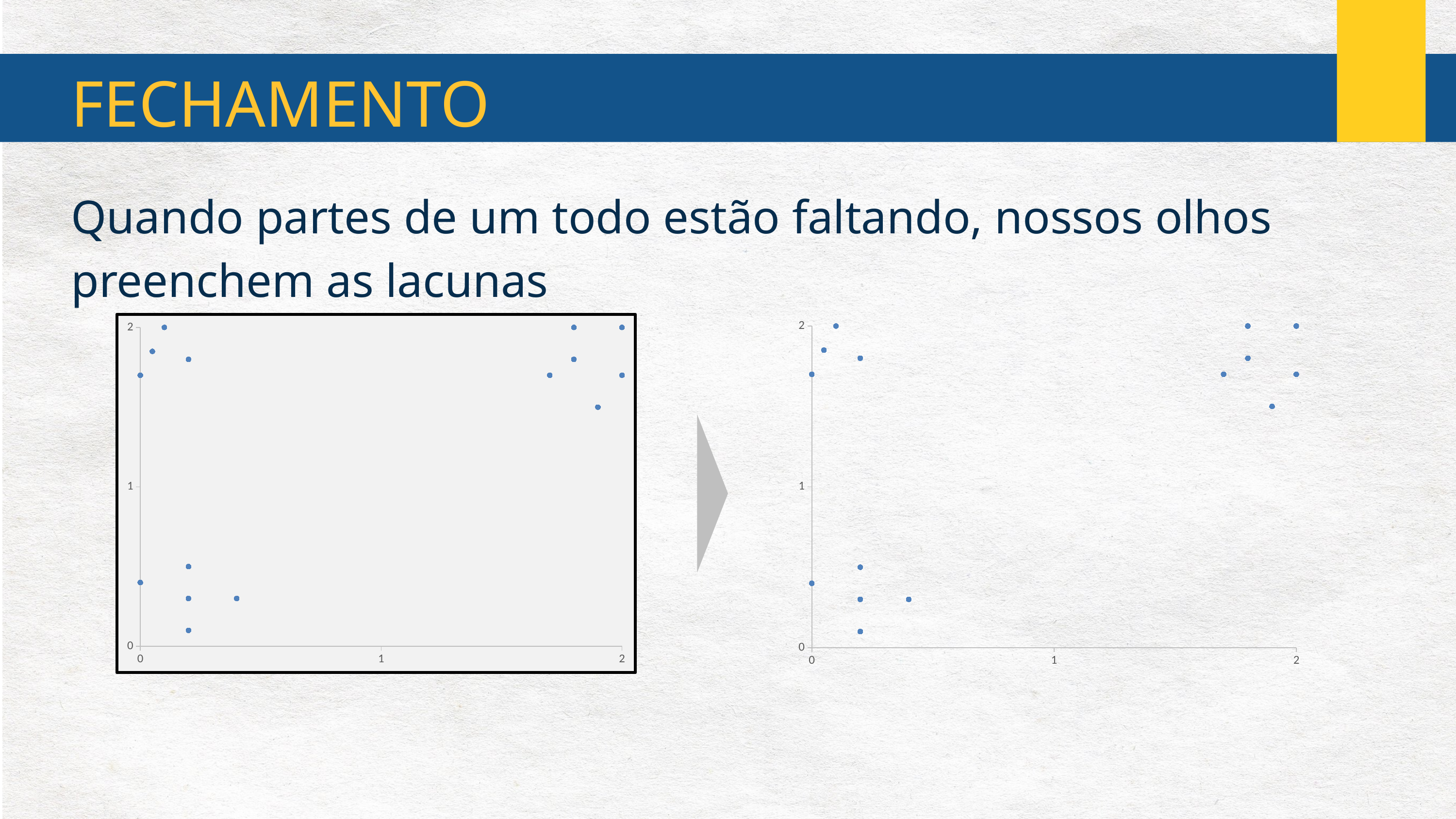
What kind of chart is the left chart on the slide? scatter chart In the left chart, what is the highest value labelled on the y axis? 2 In the right chart, how many points have a y value greater than 1? 10 How many data points are plotted in the left chart? 15 In the left chart, how many points have an x value greater than 1? 6 What kind of chart is the right chart on the slide? scatter chart In the right chart, are there more points above the y value 1 or below it? above How many charts are shown on the slide? 2